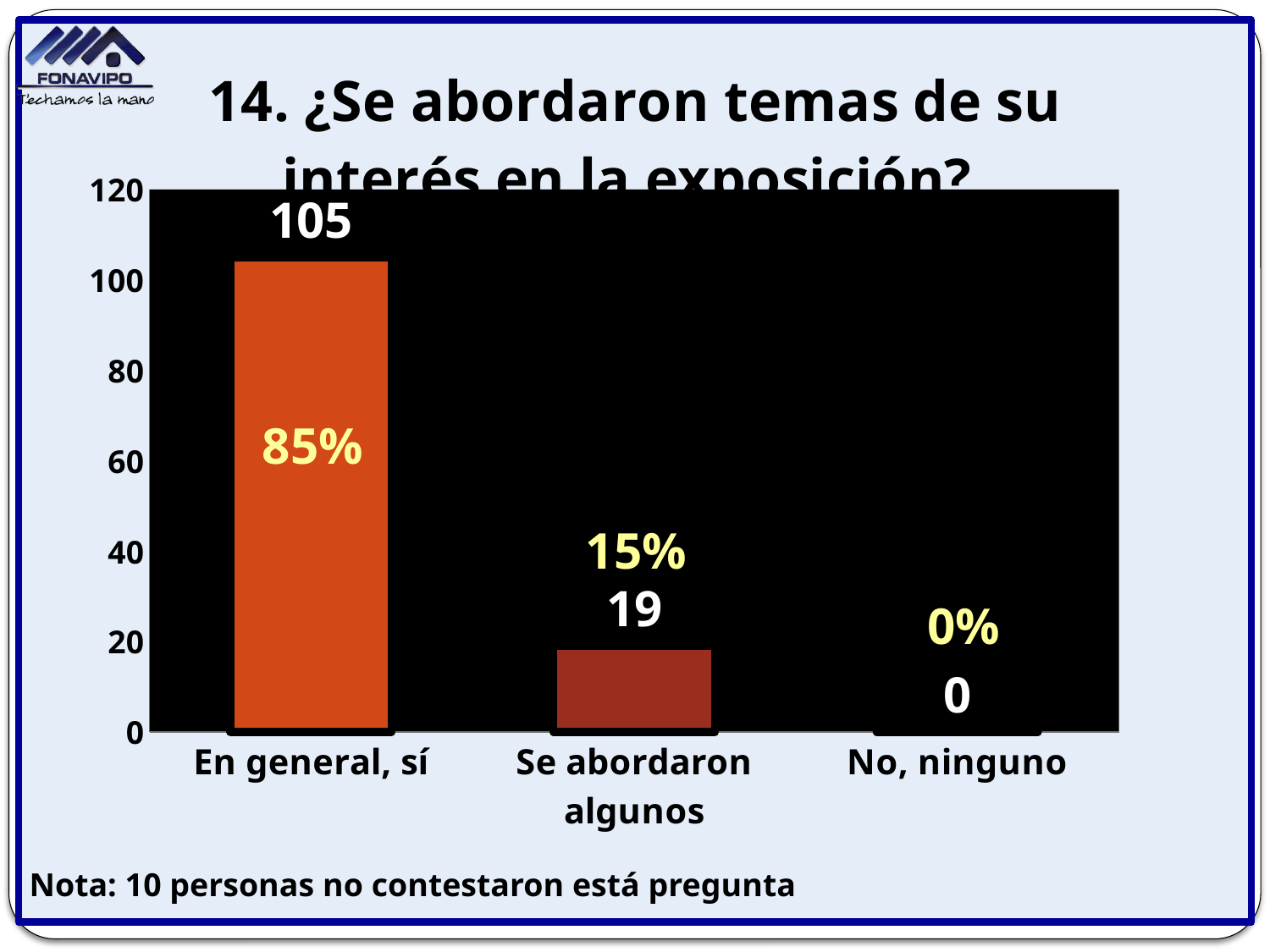
What kind of chart is shown on the slide? bar chart What percentage is shown for "En general, sí"? 85% Which category has the highest value? En general, sí What percentage is shown for "Se abordaron algunos"? 15% What is the value for "No, ninguno"? 0 Which category has the lowest value? No, ninguno What is the value for "Se abordaron algunos"? 19 Which is larger, the value for "Se abordaron algunos" or the value for "No, ninguno"? Se abordaron algunos Is the value for "En general, sí" greater or less than 100? greater What is the value for "En general, sí"? 105 How many categories are shown on the x axis? 3 What is the difference between the values for "En general, sí" and "Se abordaron algunos"? 86